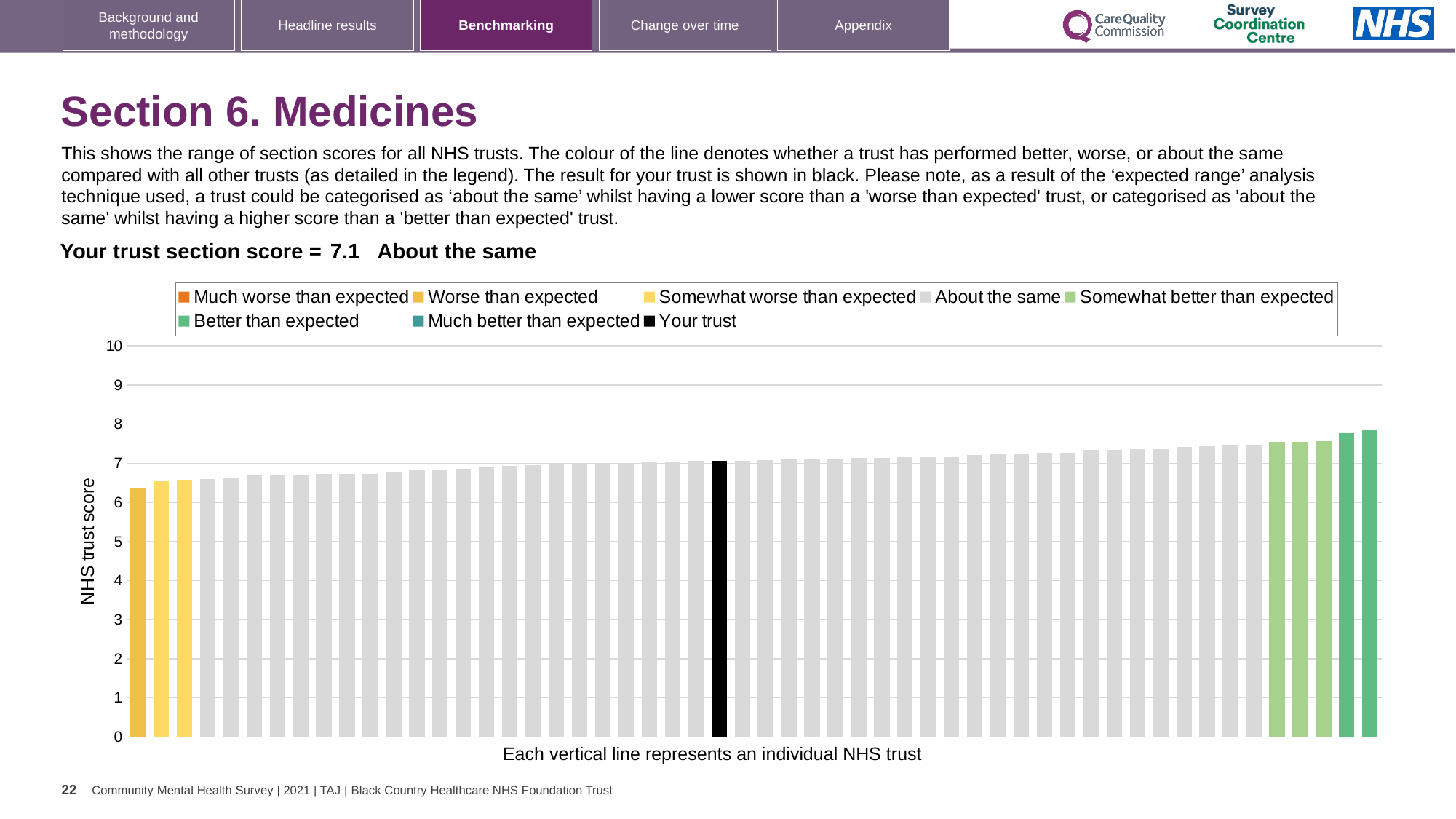
Which performance category is your trust placed in for Section 6. Medicines? About the same What colour is used for the bar representing your trust? black How many entries does the chart legend list? 8 What kind of chart is shown on the slide? bar chart How many bars are coloured in the yellow 'worse than expected' shades at the left of the chart? 3 What is the section score for your trust shown on the slide? 7.1 What is the label on the vertical axis of the chart? NHS trust score Is the value for your trust (the black bar) greater or less than 5? greater Is the value of the rightmost bar greater or less than 7? greater Is the black bar for your trust higher or lower than the rightmost bar? lower Is the value of the leftmost bar greater or less than 6? greater Do the bar values rise or fall from left to right along the x axis? rise